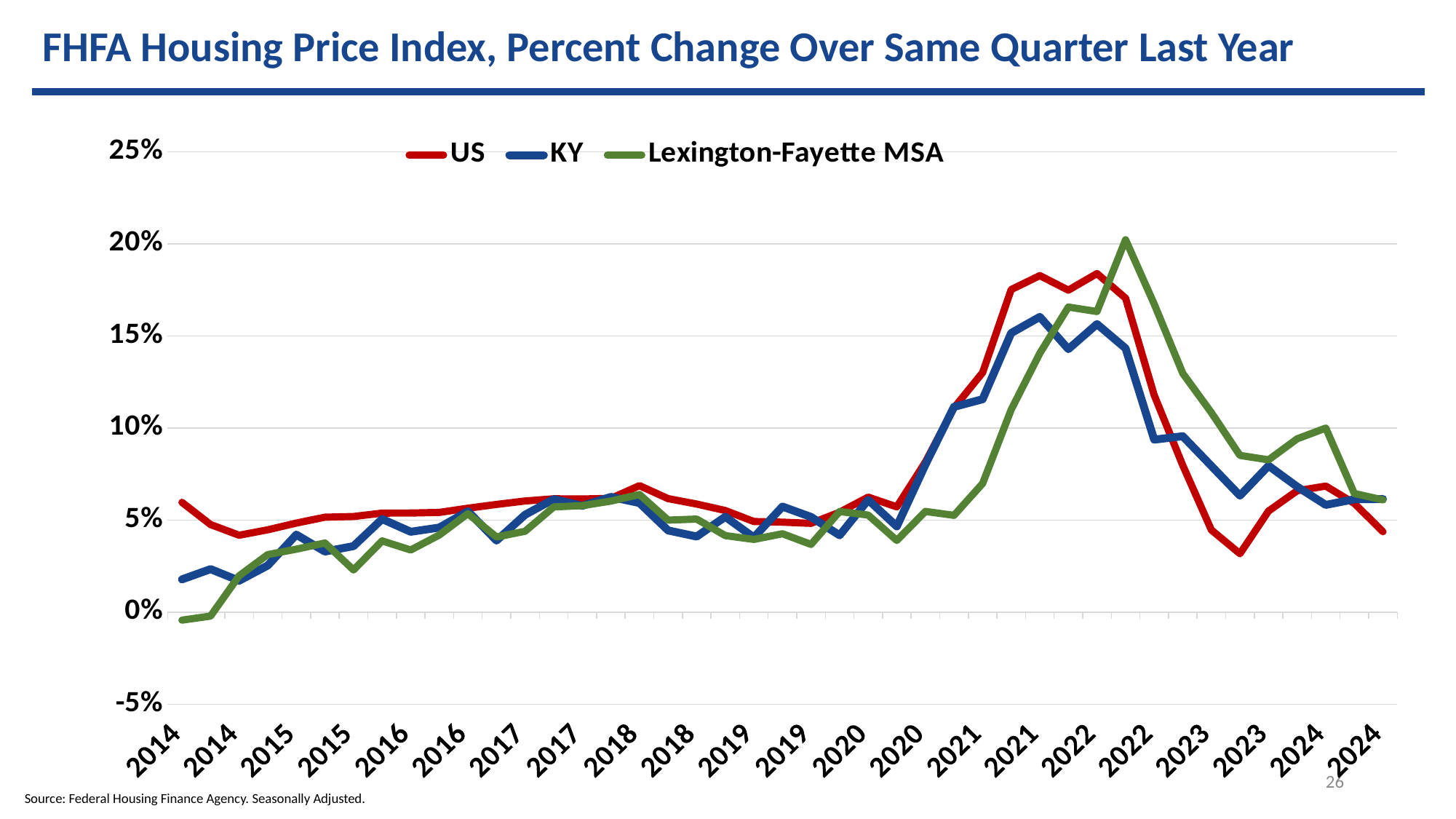
Which series reaches the highest value anywhere on the chart? Lexington-Fayette MSA Is the peak value of the Lexington-Fayette MSA line greater or less than 15%? greater At the first 2023 point, which is higher: the US line or the Lexington-Fayette MSA line? Lexington-Fayette MSA At the first 2014 point, is the Lexington-Fayette MSA value greater or less than 5%? less What kind of chart is shown on the slide? Line chart Is the peak value of the KY line greater or less than 20%? less How many series does the legend list? 3 Does the US line rise or fall between its 2022 peak and 2023? Fall What is the title of the chart? FHFA Housing Price Index, Percent Change Over Same Quarter Last Year At the first 2014 point, which is higher: the US line or the Lexington-Fayette MSA line? US Which colour is used for the Lexington-Fayette MSA line? Green